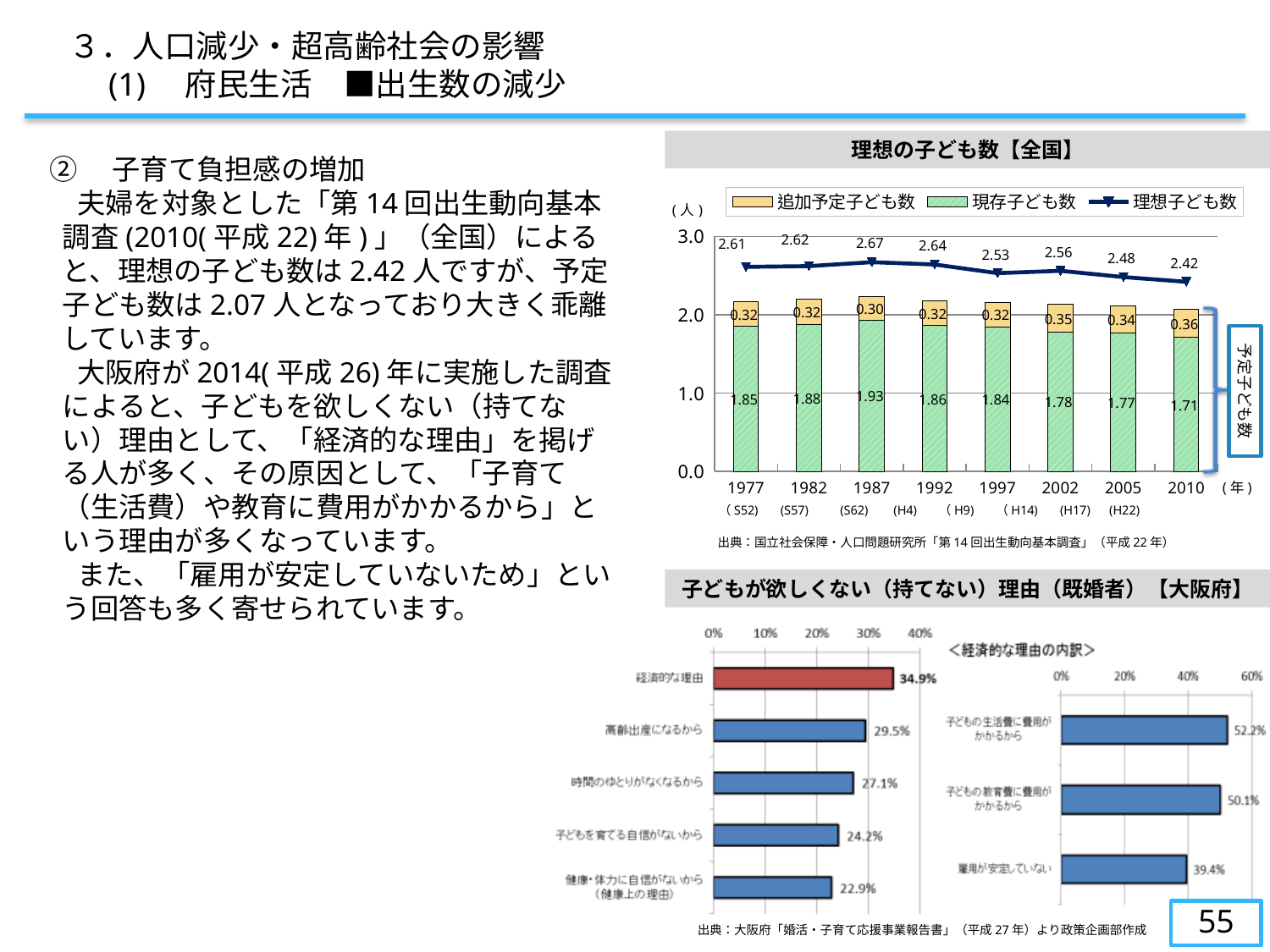
In the chart titled 子どもが欲しくない（持てない）理由（既婚者）【大阪府】, what is the value for 経済的な理由? 34.9% In the chart titled 理想の子ども数【全国】, how many years are shown on the x axis? 8 In the chart titled 理想の子ども数【全国】, which year has the highest 理想子ども数? 1987 In the chart titled 理想の子ども数【全国】, how many series does the legend list? 3 In the chart titled 理想の子ども数【全国】, does the 理想子ども数 line rise or fall from 1992 to 2010? fall In the chart titled ＜経済的な理由の内訳＞, which is larger: 子どもの生活費に費用がかかるから or 子どもの教育費に費用がかかるから? 子どもの生活費に費用がかかるから In the chart titled 子どもが欲しくない（持てない）理由（既婚者）【大阪府】, which reason has the lowest value? 健康・体力に自信がないから（健康上の理由） In the chart titled 理想の子ども数【全国】, what is the value of 現存子ども数 for 1987? 1.93 In the chart titled 子どもが欲しくない（持てない）理由（既婚者）【大阪府】, what is the difference between 高齢出産になるから and 時間のゆとりがなくなるから? 2.4% In the chart titled 理想の子ども数【全国】, what is the value of 理想子ども数 for 2010? 2.42 In the chart titled ＜経済的な理由の内訳＞, what is the value for 雇用が安定していない? 39.4% In the chart titled 理想の子ども数【全国】, what is the total of the stacked bar (追加予定子ども数 plus 現存子ども数) for 2010? 2.07